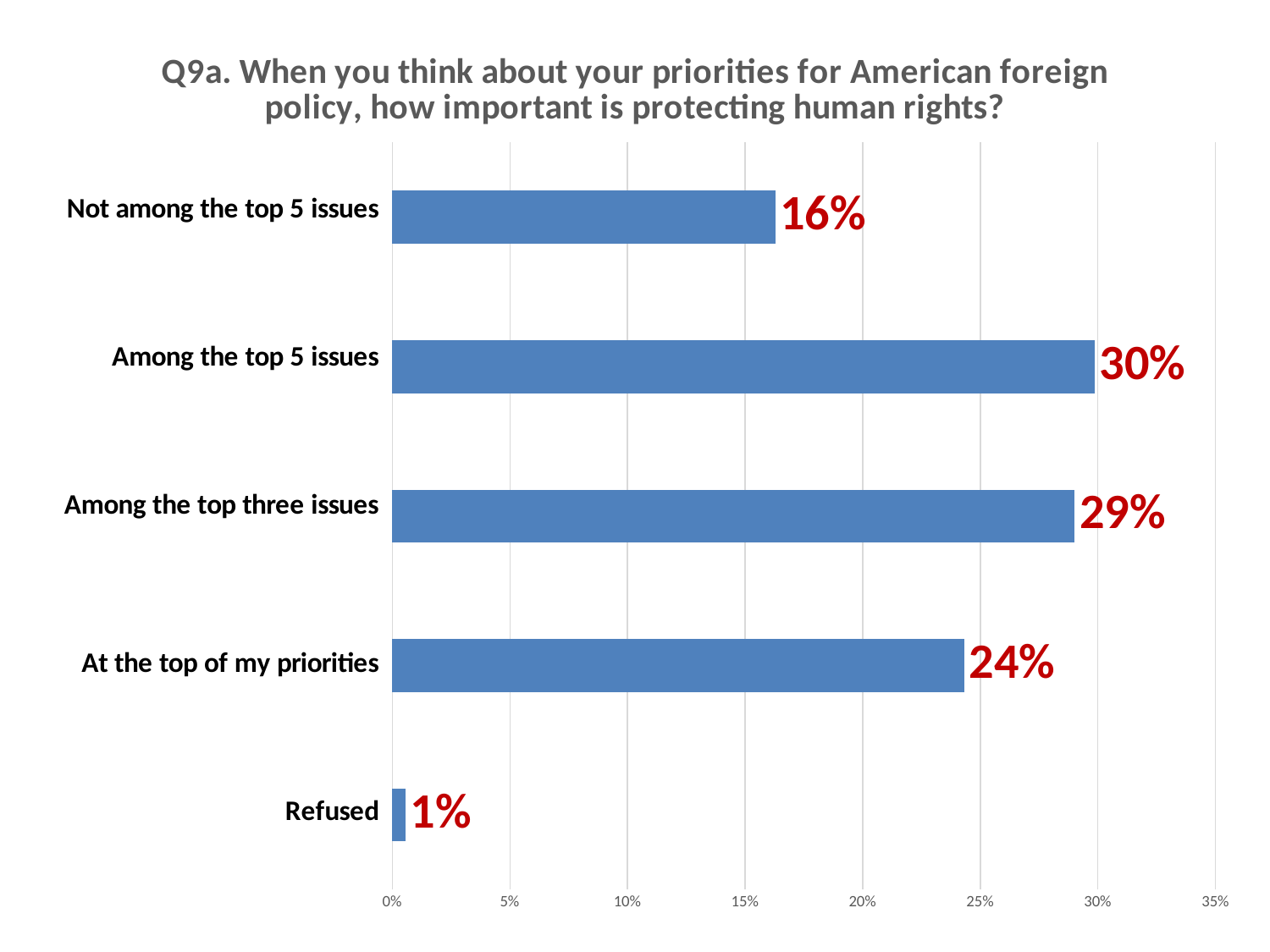
What percentage of respondents said protecting human rights is 'Not among the top 5 issues'? 16% Which response category has the lowest percentage? Refused What is the maximum value shown on the horizontal axis? 35% What percentage of respondents said protecting human rights is 'Among the top 5 issues'? 30% What percentage of respondents said protecting human rights is 'At the top of my priorities'? 24% What percentage of respondents 'Refused'? 1% Which is larger: the value for 'At the top of my priorities' or the value for 'Not among the top 5 issues'? At the top of my priorities Is the value for 'Among the top three issues' greater or less than 25%? greater What is the difference in percentage points between 'Among the top three issues' and 'Not among the top 5 issues'? 13 Which response category has the highest percentage? Among the top 5 issues What kind of chart is shown on the slide? Bar chart How many response categories are shown in the chart? 5